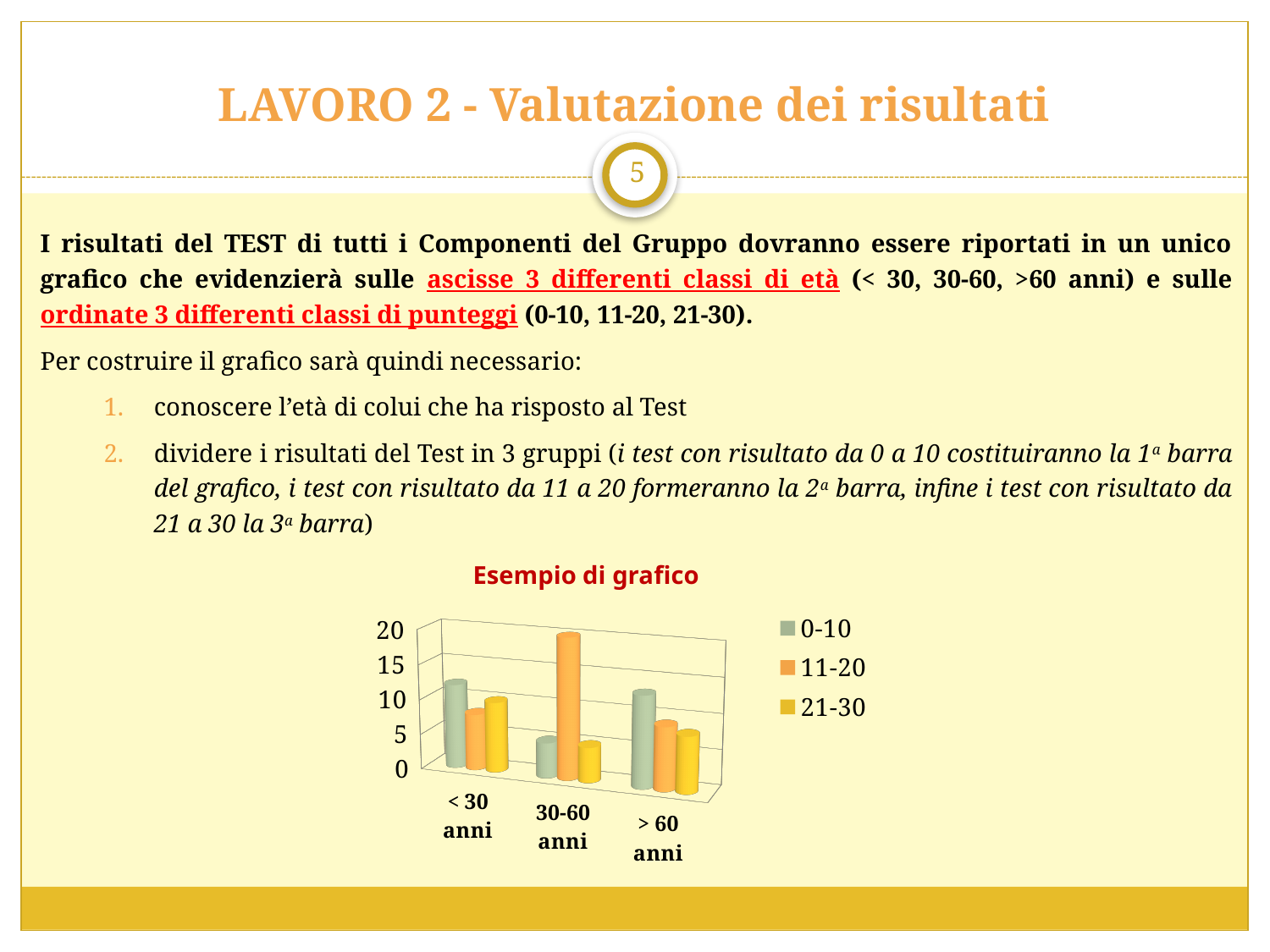
What kind of chart is shown on the slide? bar chart Which is larger: the 0-10 bar for < 30 anni or the 0-10 bar for 30-60 anni? < 30 anni Which series are listed in the chart's legend? 0-10, 11-20, 21-30 What is the title of the chart? Esempio di grafico Within the > 60 anni category, which series has the highest bar? 0-10 Is the value for 0-10 in the > 60 anni category greater or less than 5? greater Within the 30-60 anni category, which series has the highest bar? 11-20 Is the value for 11-20 in the < 30 anni category greater or less than 10? less Is the value for 11-20 in the 30-60 anni category greater or less than 15? greater Which age category has the tallest bar in the chart? 30-60 anni How many age categories are shown on the x axis of the chart? 3 How many series does the chart's legend list? 3